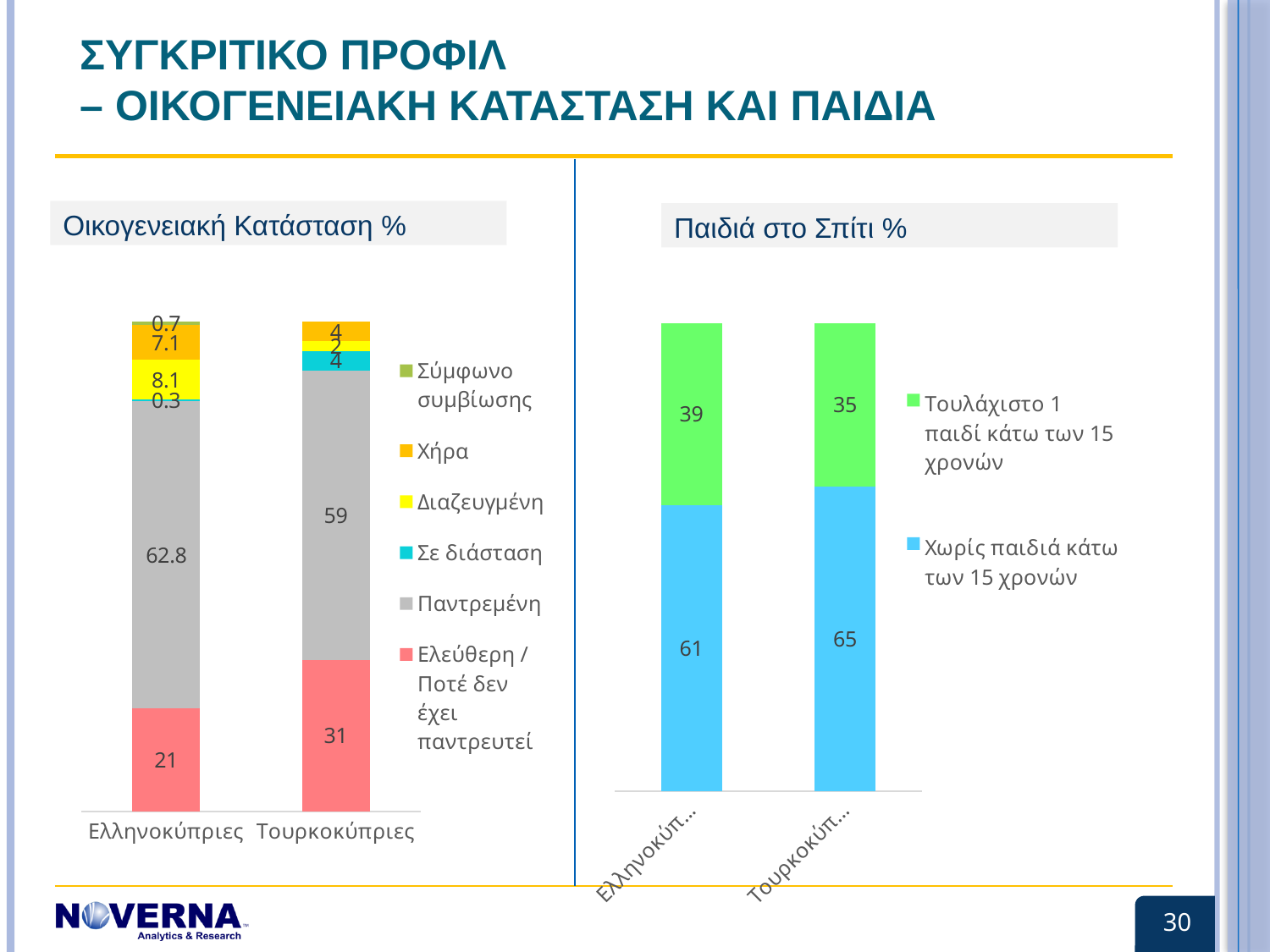
In the chart titled 'Οικογενειακή Κατάσταση %', how many series does the legend list? 6 In the chart titled 'Οικογενειακή Κατάσταση %', what is the value for 'Ελεύθερη / Ποτέ δεν έχει παντρευτεί' for Τουρκοκύπριες? 31 In the chart titled 'Οικογενειακή Κατάσταση %', which group has the larger value for 'Ελεύθερη / Ποτέ δεν έχει παντρευτεί', Ελληνοκύπριες or Τουρκοκύπριες? Τουρκοκύπριες In the chart titled 'Οικογενειακή Κατάσταση %', how many categories are shown on the x axis? 2 In the chart titled 'Οικογενειακή Κατάσταση %', what is the difference between the Παντρεμένη values for Ελληνοκύπριες and Τουρκοκύπριες? 3.8 In the chart titled 'Παιδιά στο Σπίτι %', how many series does the legend list? 2 In the chart titled 'Οικογενειακή Κατάσταση %', what is the value for Παντρεμένη for Ελληνοκύπριες? 62.8 What kind of chart is the chart titled 'Οικογενειακή Κατάσταση %'? Stacked bar chart In the chart titled 'Παιδιά στο Σπίτι %', what is the value for 'Χωρίς παιδιά κάτω των 15 χρονών' for the left bar (Ελληνοκύπ...)? 61 In the chart titled 'Παιδιά στο Σπίτι %', what is the difference between the 'Χωρίς παιδιά κάτω των 15 χρονών' values of the two bars? 4 In the chart titled 'Οικογενειακή Κατάσταση %', what is the value for Διαζευγμένη for Ελληνοκύπριες? 8.1 In the chart titled 'Παιδιά στο Σπίτι %', what is the value for 'Τουλάχιστο 1 παιδί κάτω των 15 χρονών' for the right bar (Τουρκοκύπ...)? 35